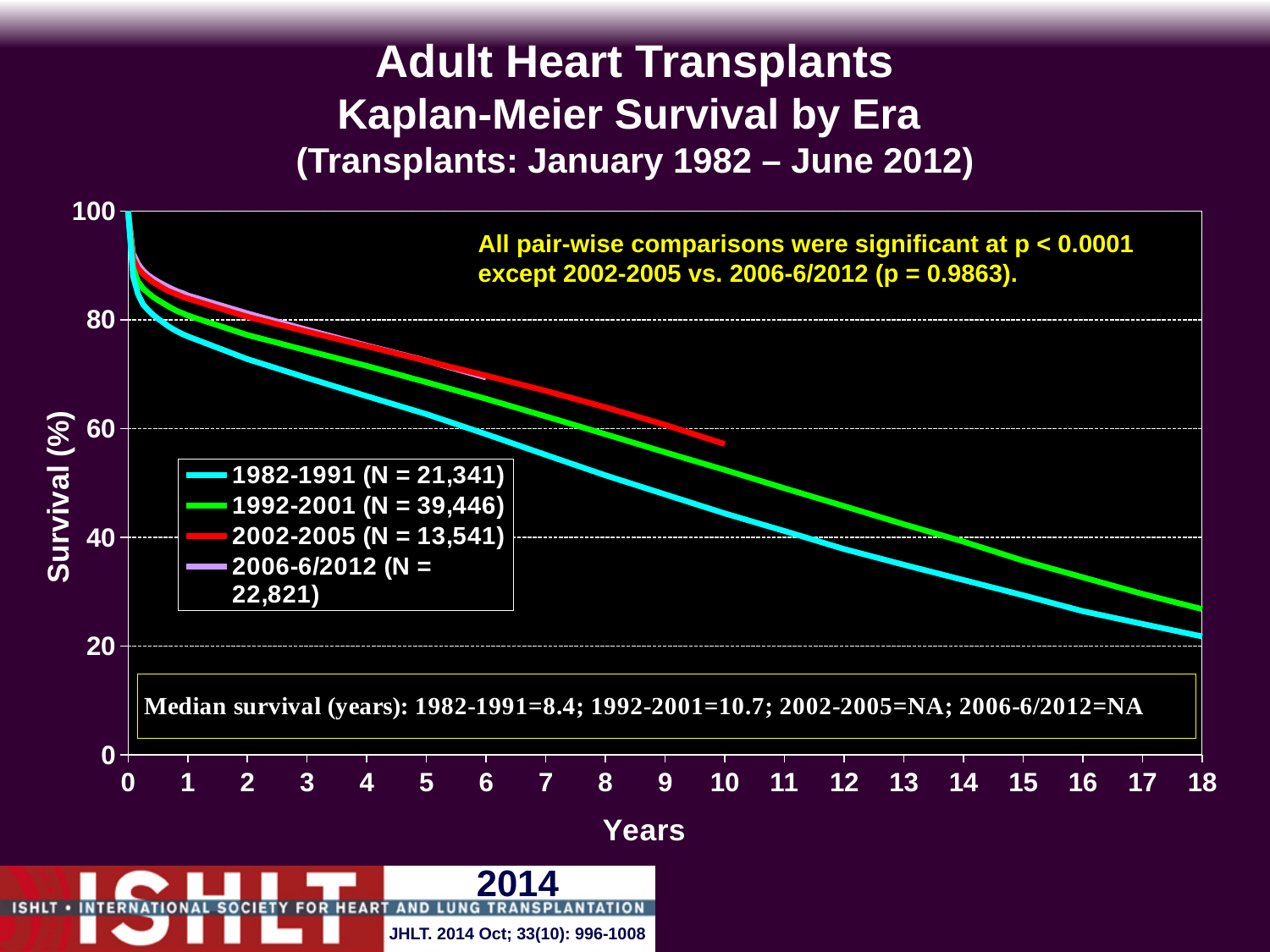
Is the survival value for 1982-1991 at 18 years greater or less than 40? less At 5 years, which era has higher survival: 2002-2005 or 1982-1991? 2002-2005 Is the survival value for 2002-2005 at 1 year greater or less than 80? greater At 10 years, which era has higher survival: 1982-1991 or 1992-2001? 1992-2001 Do the survival curves rise or fall as years increase along the x axis? fall Is the survival value for 1992-2001 at 18 years greater or less than 20? greater What kind of chart is shown on the slide? line chart According to the legend, what is N for the 1982-1991 era? 21,341 What is the median survival in years for the 1992-2001 era, as printed on the slide? 10.7 Which era has the lowest survival curve across the chart? 1982-1991 How many series does the legend list? 4